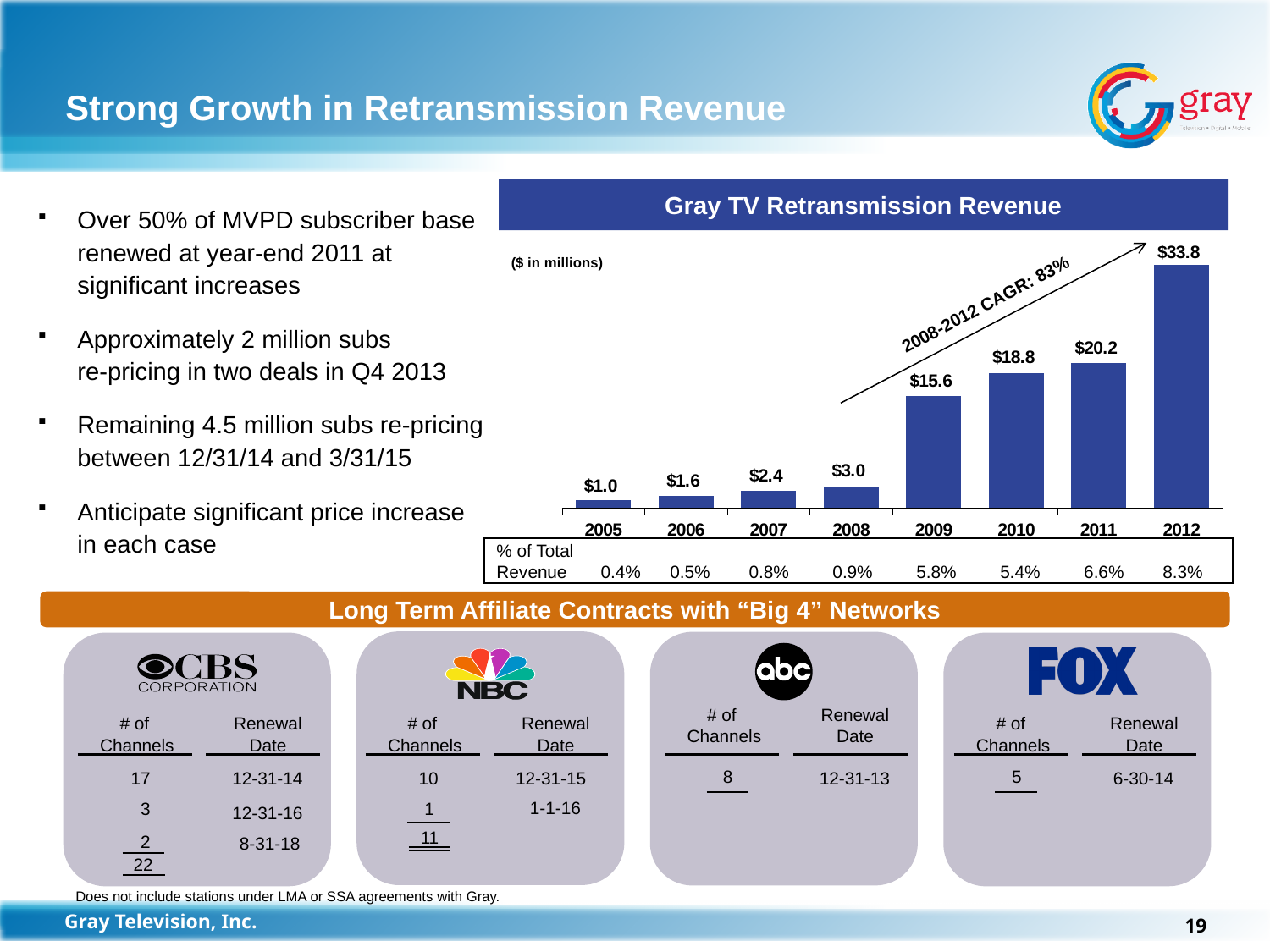
Which year has the lowest Gray TV Retransmission Revenue? 2005 What is the Gray TV Retransmission Revenue value for 2012? $33.8 Which year has the highest Gray TV Retransmission Revenue? 2012 What 2008-2012 CAGR is annotated on the Gray TV Retransmission Revenue chart? 83% What type of chart is the Gray TV Retransmission Revenue chart? Bar chart What is the Gray TV Retransmission Revenue value for 2009? $15.6 What is the difference in Gray TV Retransmission Revenue between 2012 and 2011? $13.6 What is the difference in Gray TV Retransmission Revenue between 2009 and 2008? $12.6 How many years are shown in the Gray TV Retransmission Revenue chart? 8 Which year has higher Gray TV Retransmission Revenue, 2010 or 2011? 2011 Does Gray TV Retransmission Revenue rise or fall from 2005 to 2012? Rise What is the Gray TV Retransmission Revenue value for 2005? $1.0